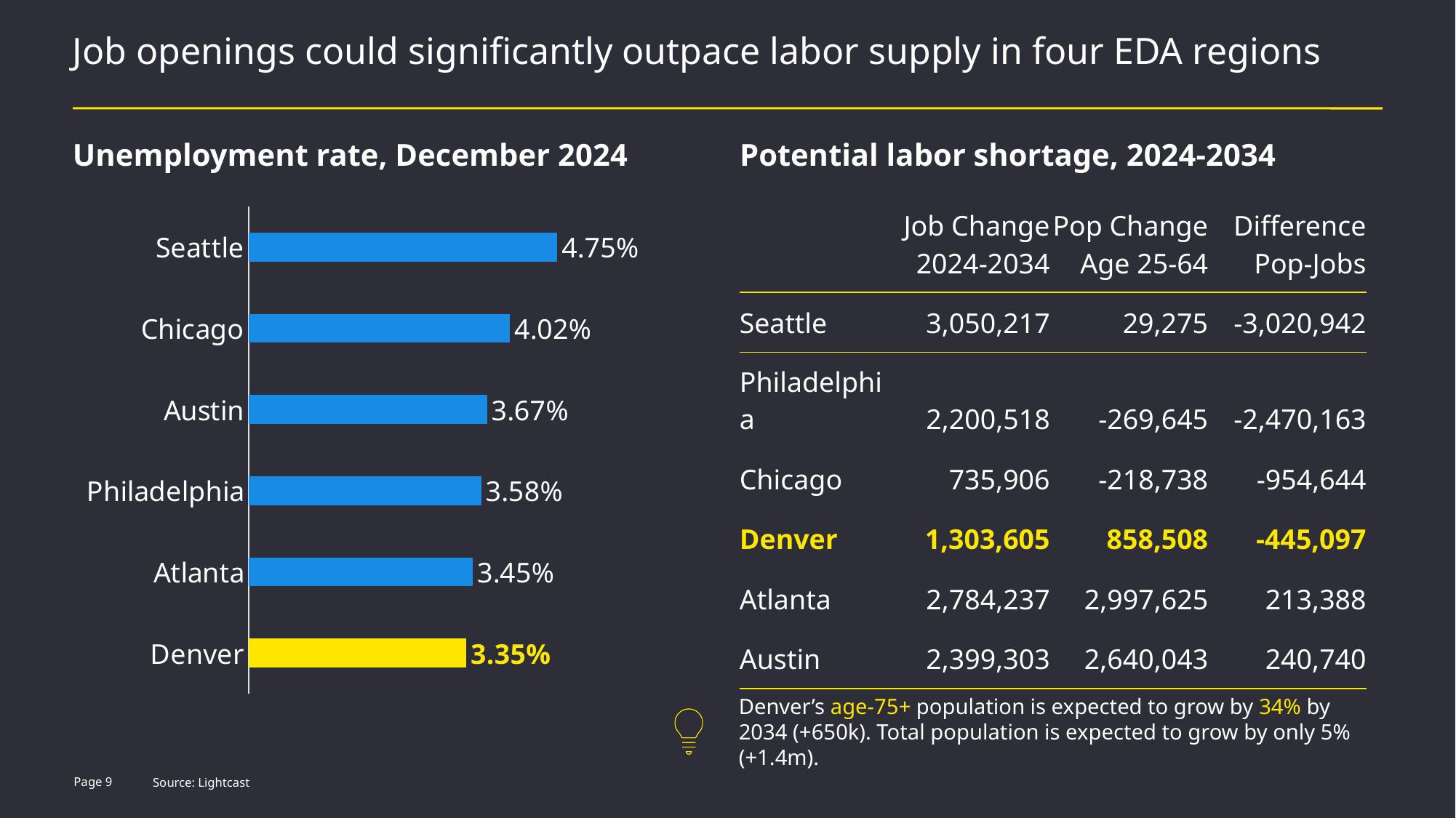
In the 'Unemployment rate, December 2024' chart, which has a higher unemployment rate, Chicago or Atlanta? Chicago What kind of chart is the 'Unemployment rate, December 2024' chart? Bar chart In the 'Unemployment rate, December 2024' chart, which city's bar is coloured yellow instead of blue? Denver In the 'Unemployment rate, December 2024' chart, which city has the highest unemployment rate? Seattle In the 'Unemployment rate, December 2024' chart, do the values rise or fall going from the top bar to the bottom bar? Fall How many cities are shown in the 'Unemployment rate, December 2024' chart? 6 In the 'Unemployment rate, December 2024' chart, what is the unemployment rate for Denver? 3.35% In the 'Unemployment rate, December 2024' chart, what is the unemployment rate for Philadelphia? 3.58% In the 'Unemployment rate, December 2024' chart, what is the difference between Seattle's and Denver's unemployment rates? 1.40 percentage points In the 'Unemployment rate, December 2024' chart, what is the difference between Chicago's and Austin's unemployment rates? 0.35 percentage points In the 'Unemployment rate, December 2024' chart, which city has the lowest unemployment rate? Denver In the 'Unemployment rate, December 2024' chart, what is the unemployment rate for Seattle? 4.75%